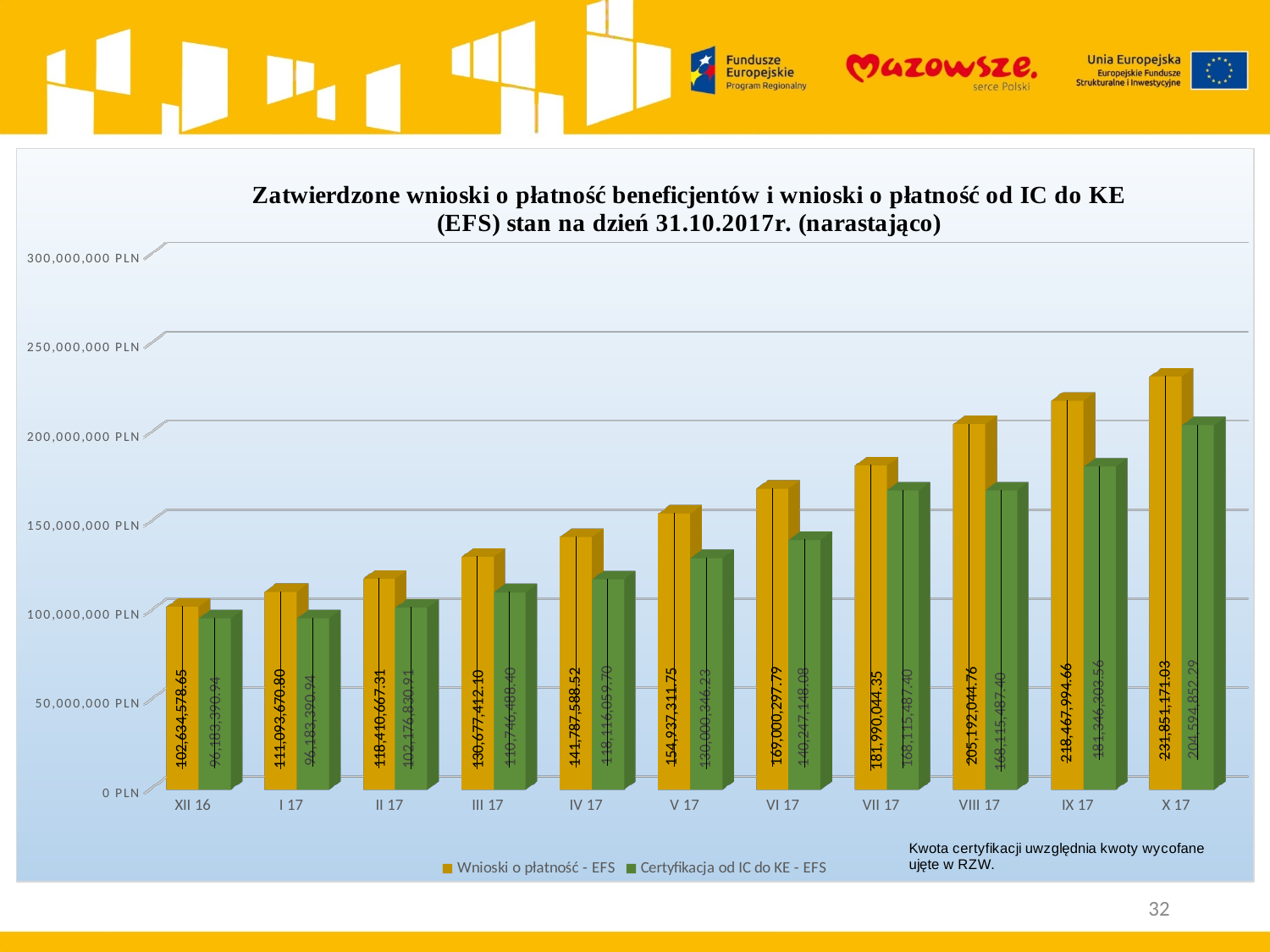
What is the value of 'Wnioski o płatność - EFS' for VI 17? 169,000,297.79 How many series does the legend list? 2 What is the value of 'Wnioski o płatność - EFS' for XII 16? 102,634,578.65 Which period has the highest value for 'Wnioski o płatność - EFS'? X 17 What is the value of 'Wnioski o płatność - EFS' for X 17? 231,851,171.03 What type of chart is shown on the slide? bar chart What is the difference between 'Wnioski o płatność - EFS' and 'Certyfikacja od IC do KE - EFS' for X 17? 27,256,318.74 Is the value of 'Wnioski o płatność - EFS' for X 17 greater or less than 200,000,000 PLN? greater Do the values of 'Wnioski o płatność - EFS' rise or fall from XII 16 to X 17? rise Which period has the lowest value for 'Wnioski o płatność - EFS'? XII 16 What is the value of 'Certyfikacja od IC do KE - EFS' for X 17? 204,594,852.29 How many time periods are shown on the x axis? 11